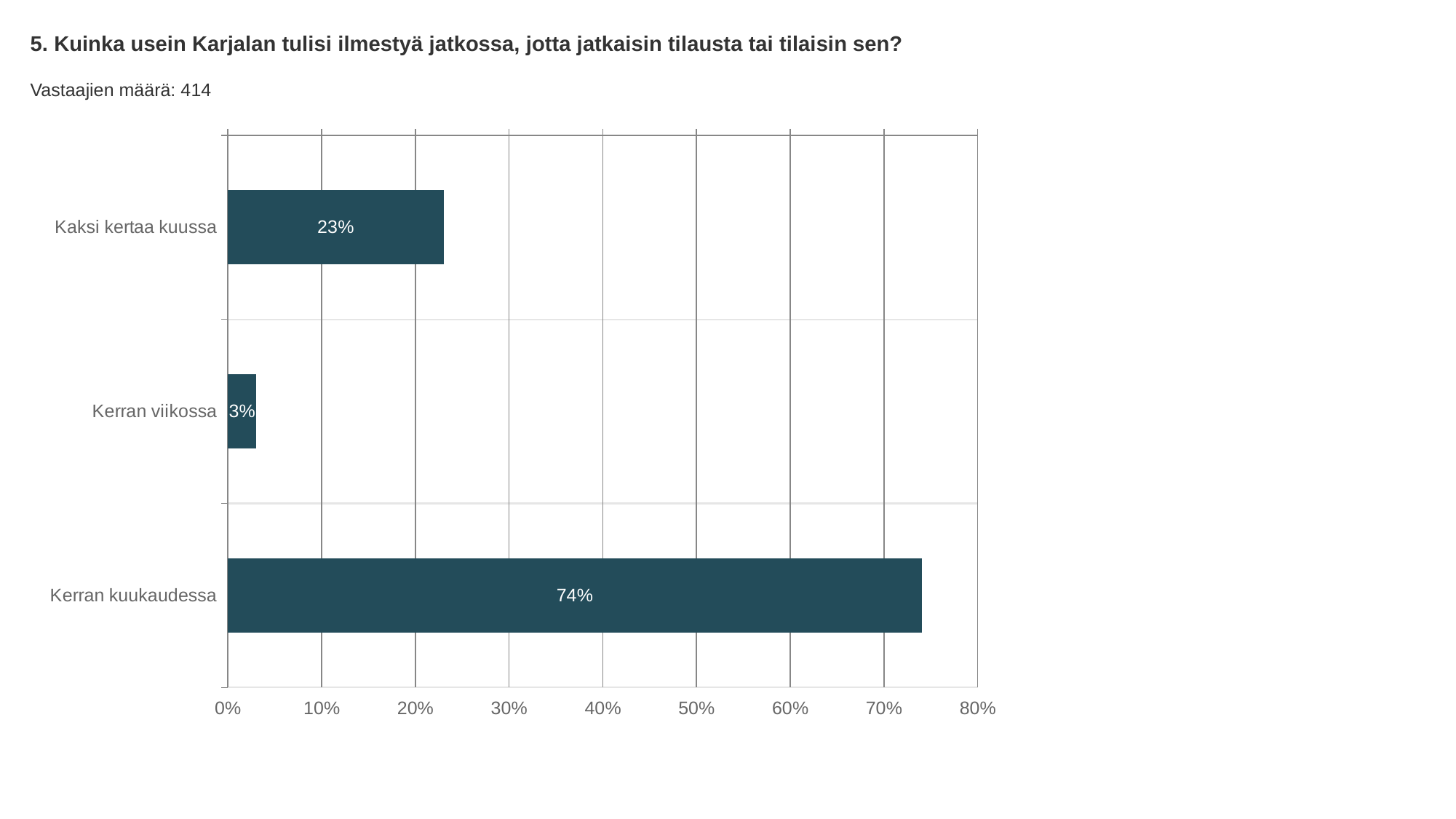
What is the value for Kaksi kertaa kuussa? 23% What is the value for Kerran viikossa? 3% How many categories are shown in the chart? 3 What is the value for Kerran kuukaudessa? 74% Which category has the highest value? Kerran kuukaudessa What is the difference between the values for Kerran kuukaudessa and Kaksi kertaa kuussa? 51% Is the value for Kerran kuukaudessa greater or less than 70%? greater What kind of chart is shown on the slide? bar chart How many respondents (Vastaajien määrä) does the slide report? 414 Which category has the lowest value? Kerran viikossa What is the difference between the values for Kaksi kertaa kuussa and Kerran viikossa? 20% Which is larger, the value for Kaksi kertaa kuussa or the value for Kerran viikossa? Kaksi kertaa kuussa